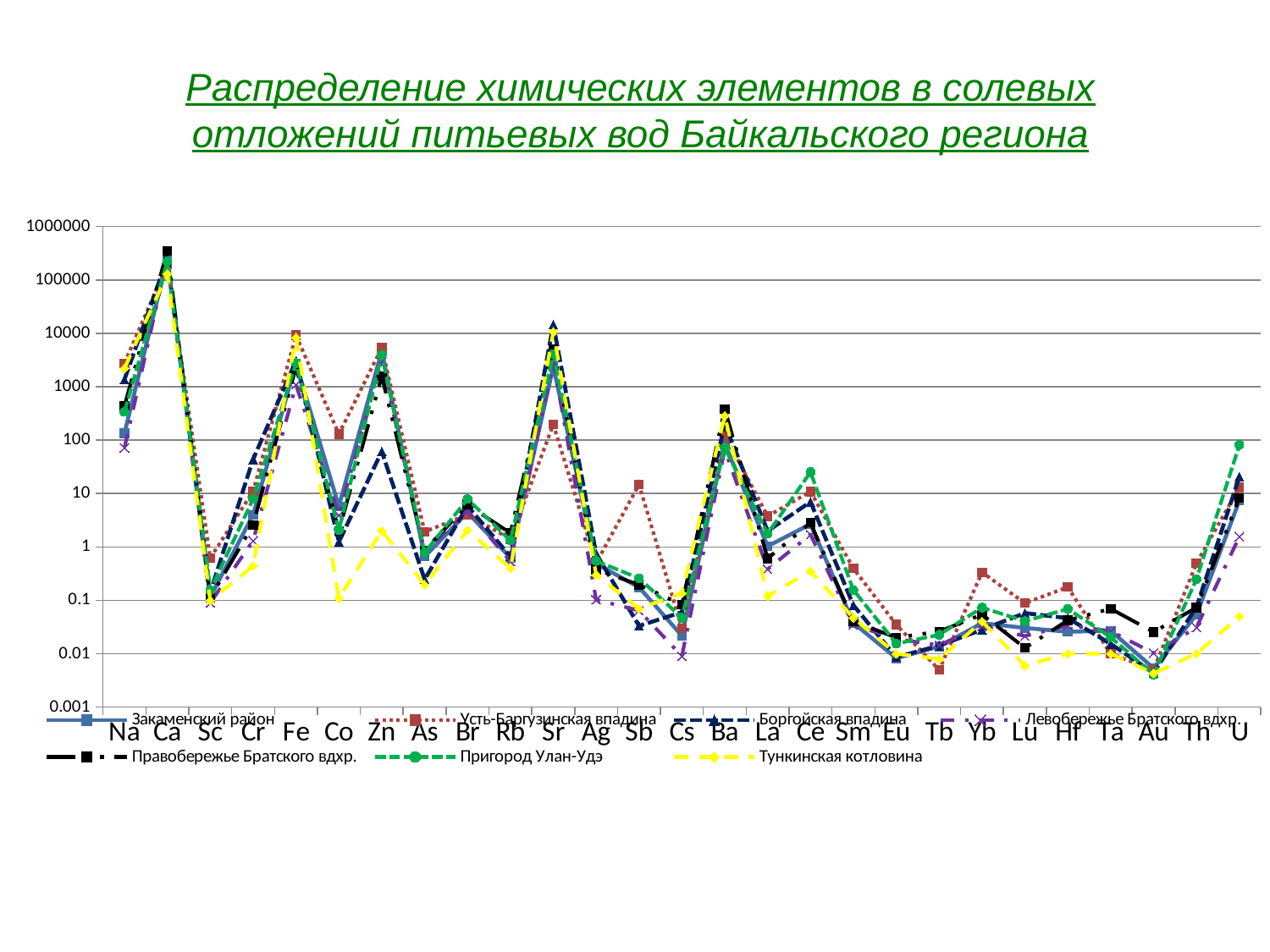
How many series does the legend list? 7 Is the value for Au in the series Тункинская котловина greater or less than 0.01? less Is the value for Sc in the series Усть-Баргузинская впадина greater or less than 1? less What is the highest tick value shown on the vertical axis? 1000000 Is the value for Ca in the series Правобережье Братского вдхр. greater or less than 100000? greater What kind of chart is shown on the slide? Line chart What is the title of the chart on the slide? Распределение химических элементов в солевых отложений питьевых вод Байкальского региона For the series Боргойская впадина, which is larger: the value for Sr or the value for Ag? Sr Which element has the highest value for the series Усть-Баргузинская впадина? Ca How many chemical elements are plotted along the x axis? 27